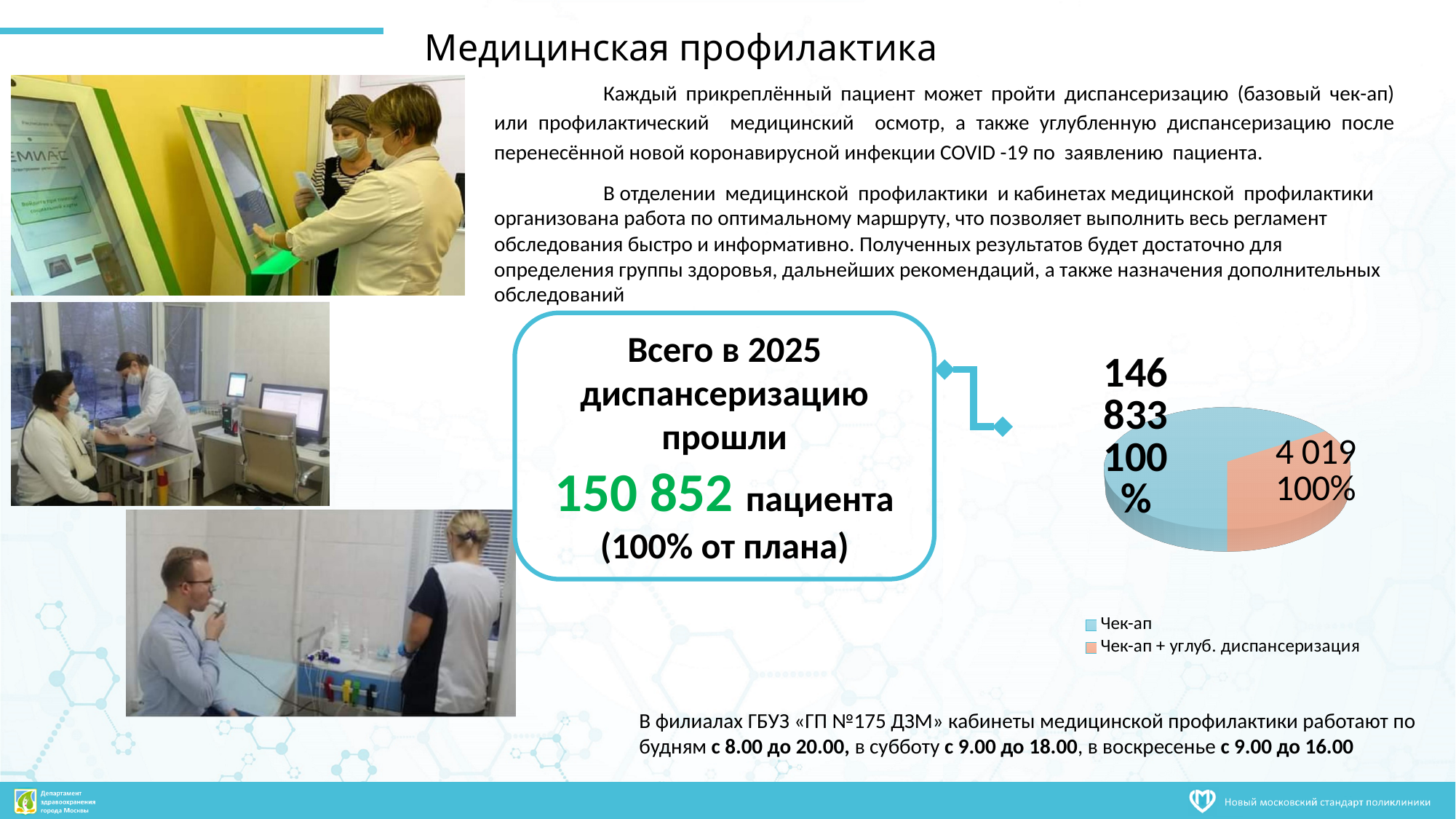
What kind of chart is shown on the right side of the slide? pie chart What is the difference between the Чек-ап value and the Чек-ап + углуб. диспансеризация value in the pie chart? 142 814 Which is larger in the pie chart: Чек-ап or Чек-ап + углуб. диспансеризация? Чек-ап What value is shown for the Чек-ап + углуб. диспансеризация slice of the pie chart? 4 019 How many entries does the legend of the pie chart list? 2 How many slices does the pie chart have? 2 What percentage label is printed next to the Чек-ап slice of the pie chart? 100% What colour is the Чек-ап slice in the pie chart? light blue What colour is the Чек-ап + углуб. диспансеризация slice in the pie chart? orange (salmon) Which slice of the pie chart is the largest? Чек-ап Which slice of the pie chart is the smallest? Чек-ап + углуб. диспансеризация What value is shown for the Чек-ап slice of the pie chart? 146 833